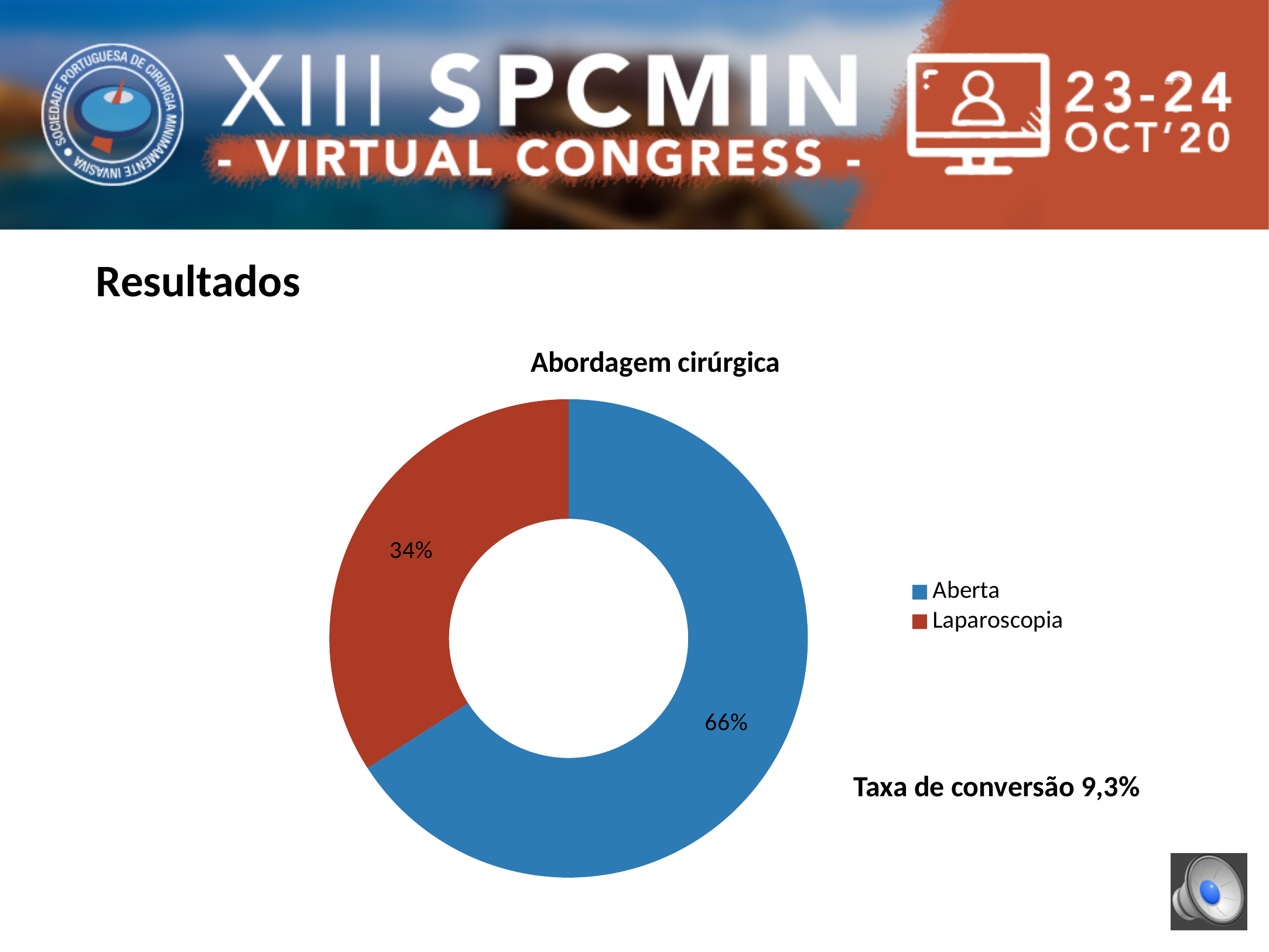
How many categories are shown in the chart? 2 What colour is the Laparoscopia slice? Red What share of the pie does Laparoscopia represent? 34% Which category has the smallest slice of the pie? Laparoscopia What kind of chart is shown on the slide? Pie chart (doughnut) What is the title of the chart? Abordagem cirúrgica What is the difference in percentage points between Aberta and Laparoscopia? 32 How many entries does the legend list? 2 Is the share for Aberta greater or less than 50%? greater What share of the pie does Aberta represent? 66% Which category has the largest slice of the pie? Aberta Which is larger, the share for Aberta or the share for Laparoscopia? Aberta